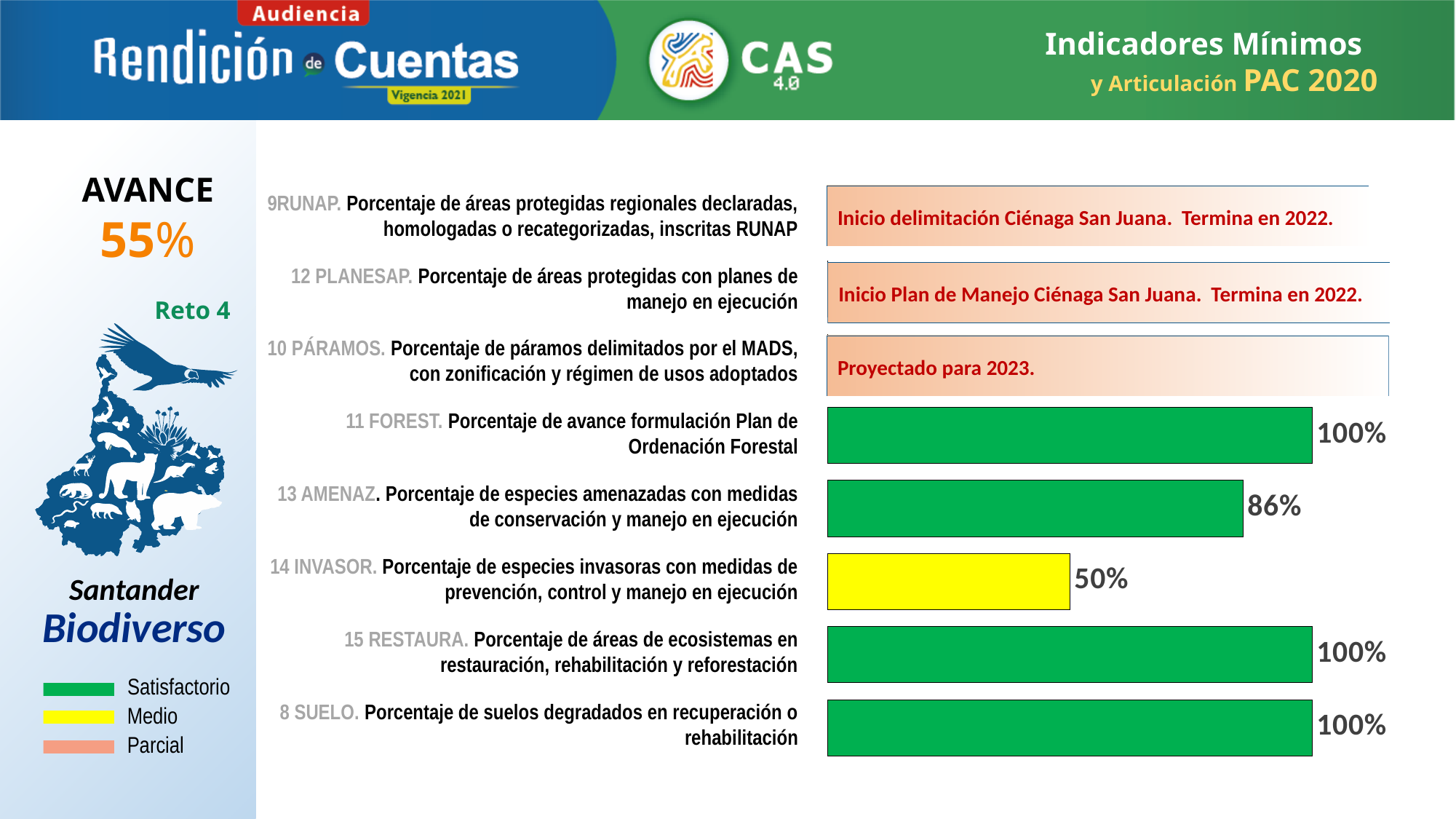
What type of chart is used to show the indicator values? Bar chart What colour is the bar for 14 INVASOR? Yellow Which is larger, the value for 13 AMENAZ or the value for 14 INVASOR? 13 AMENAZ What is the difference between the values for 13 AMENAZ and 14 INVASOR? 36% What is the value shown for the indicator 13 AMENAZ? 86% According to the legend, what does the yellow colour represent? Medio Which indicator has the lowest percentage value among the bars with data labels? 14 INVASOR What is the value shown for the indicator 11 FOREST? 100% How many indicators show a bar with a percentage value of 100%? 3 What is the value shown for the indicator 8 SUELO? 100% What is the difference between the values for 15 RESTAURA and 13 AMENAZ? 14% What is the value shown for the indicator 14 INVASOR? 50%